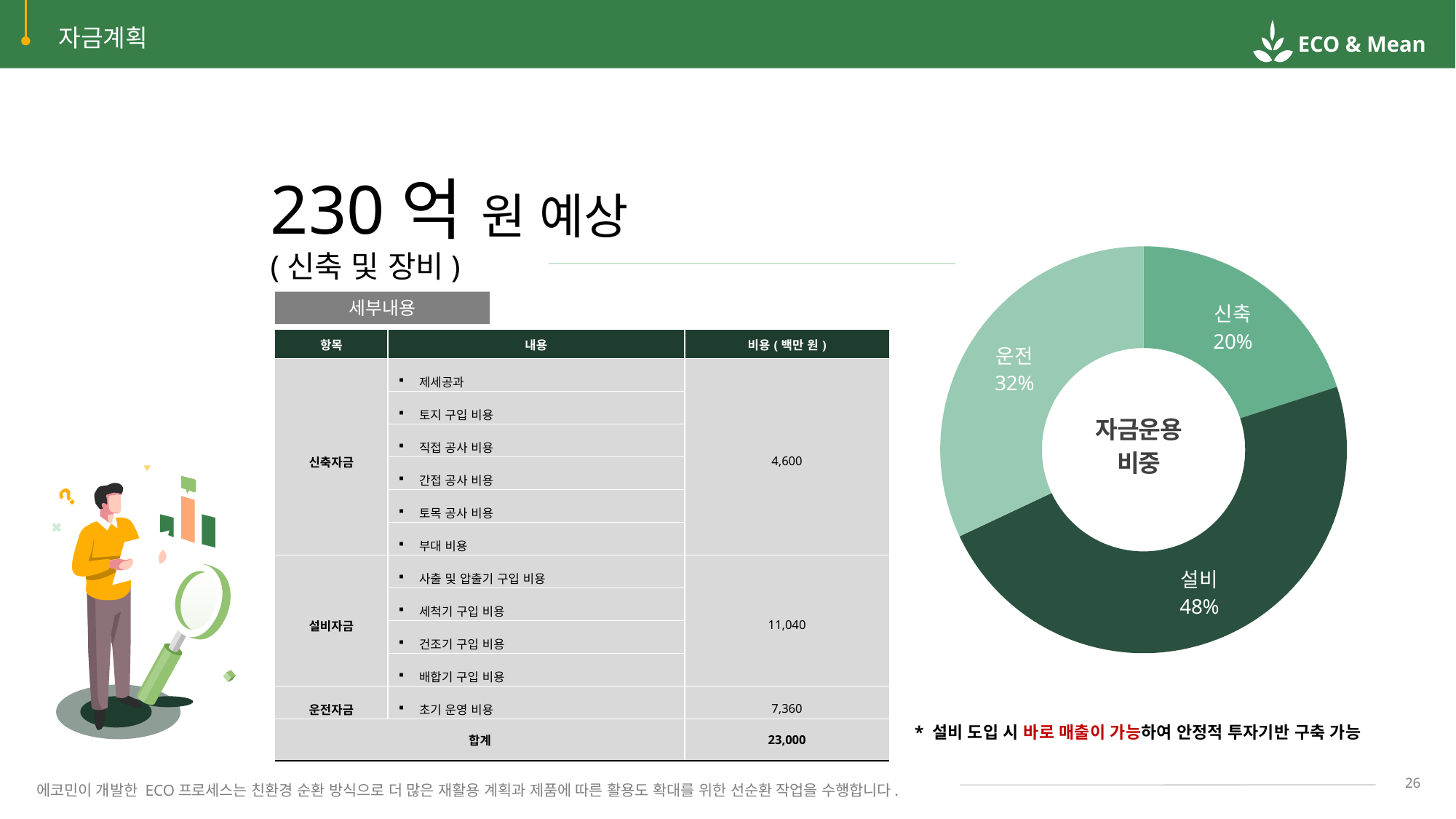
Which slice of the donut chart is the smallest? 신축 Which is larger in the donut chart, 운전 or 신축? 운전 Which slice of the donut chart is the largest? 설비 What share of the donut chart does 신축 represent? 20% Is the share for 설비 in the donut chart greater or less than 50%? less What is the title shown in the centre of the donut chart? 자금운용 비중 How many slices does the donut chart have? 3 What is the difference in percentage points between the 운전 and 신축 slices? 12% What kind of chart is shown on the slide? Donut (pie) chart What is the difference in percentage points between the 설비 and 신축 slices? 28% What share of the donut chart does 운전 represent? 32% What share of the donut chart does 설비 represent? 48%